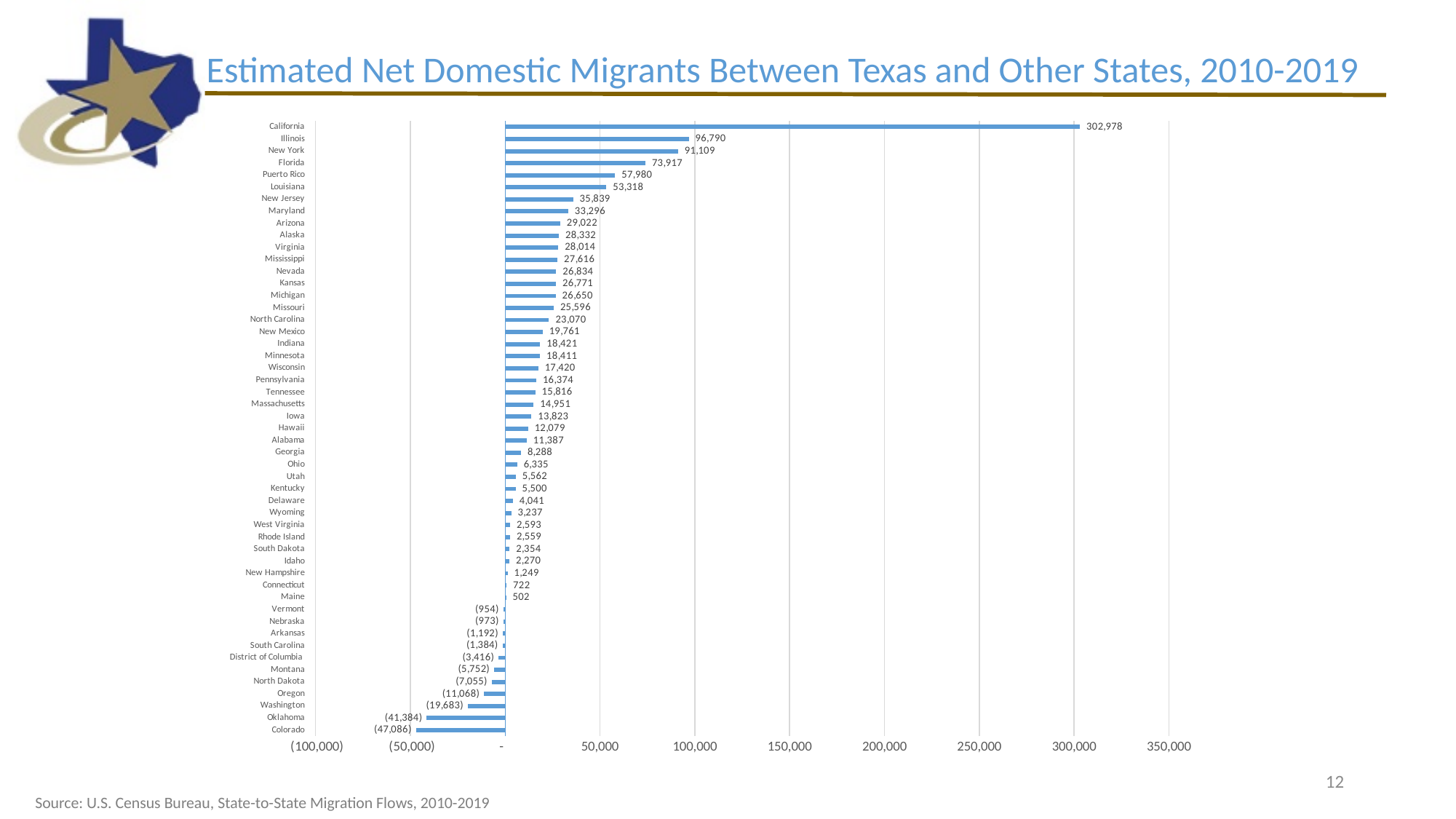
What is the title of the chart? Estimated Net Domestic Migrants Between Texas and Other States, 2010-2019 What is the difference between the values for Florida and Puerto Rico? 15,937 Which has a larger value, New York or Louisiana? New York Which state has the highest net domestic migration value? California Is the value for Illinois greater or less than 50,000? greater What value is shown for Washington? (19,683) What value is shown for Colorado? (47,086) What is the value shown for Florida? 73,917 What is the difference between the values for California and Illinois? 206,188 What is the estimated net domestic migration value for California? 302,978 What kind of chart is shown on the slide? Bar chart Which state has the lowest (most negative) value on the chart? Colorado